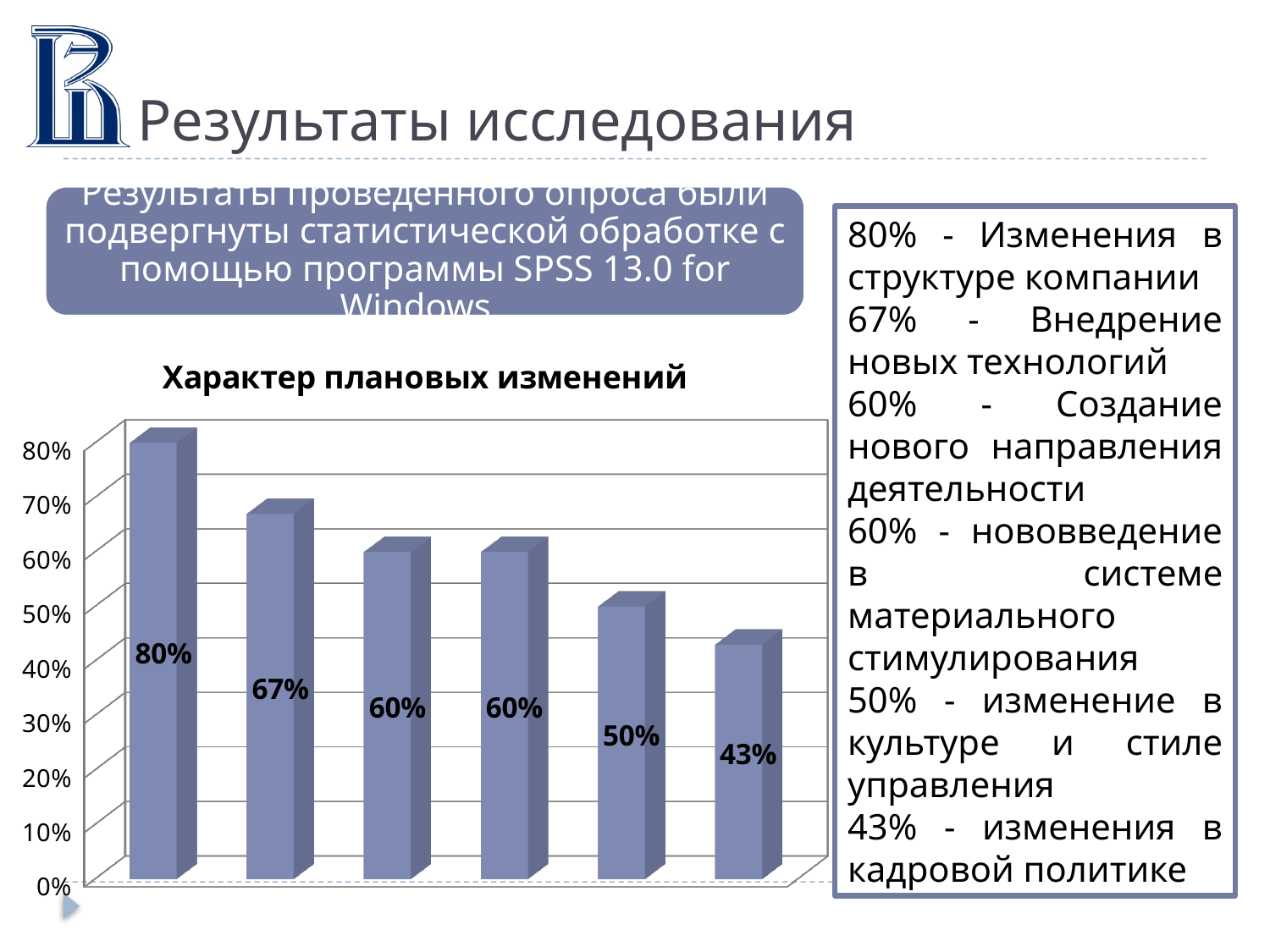
What is the value of the last (rightmost) bar in the chart? 43% What is the highest value shown in the chart? 80% What is the title of the chart? Характер плановых изменений What is the lowest value shown in the chart? 43% What is the value of the first (leftmost) bar in the chart? 80% What is the difference between the first bar and the last bar in the chart? 37% Do the bar values rise or fall from left to right across the chart? fall What is the value of the fifth bar in the chart? 50% What kind of chart is shown on the slide? bar chart How many bars does the chart have? 6 What is the value of the second bar in the chart? 67% Which is larger, the second bar or the fifth bar? the second bar (67%)